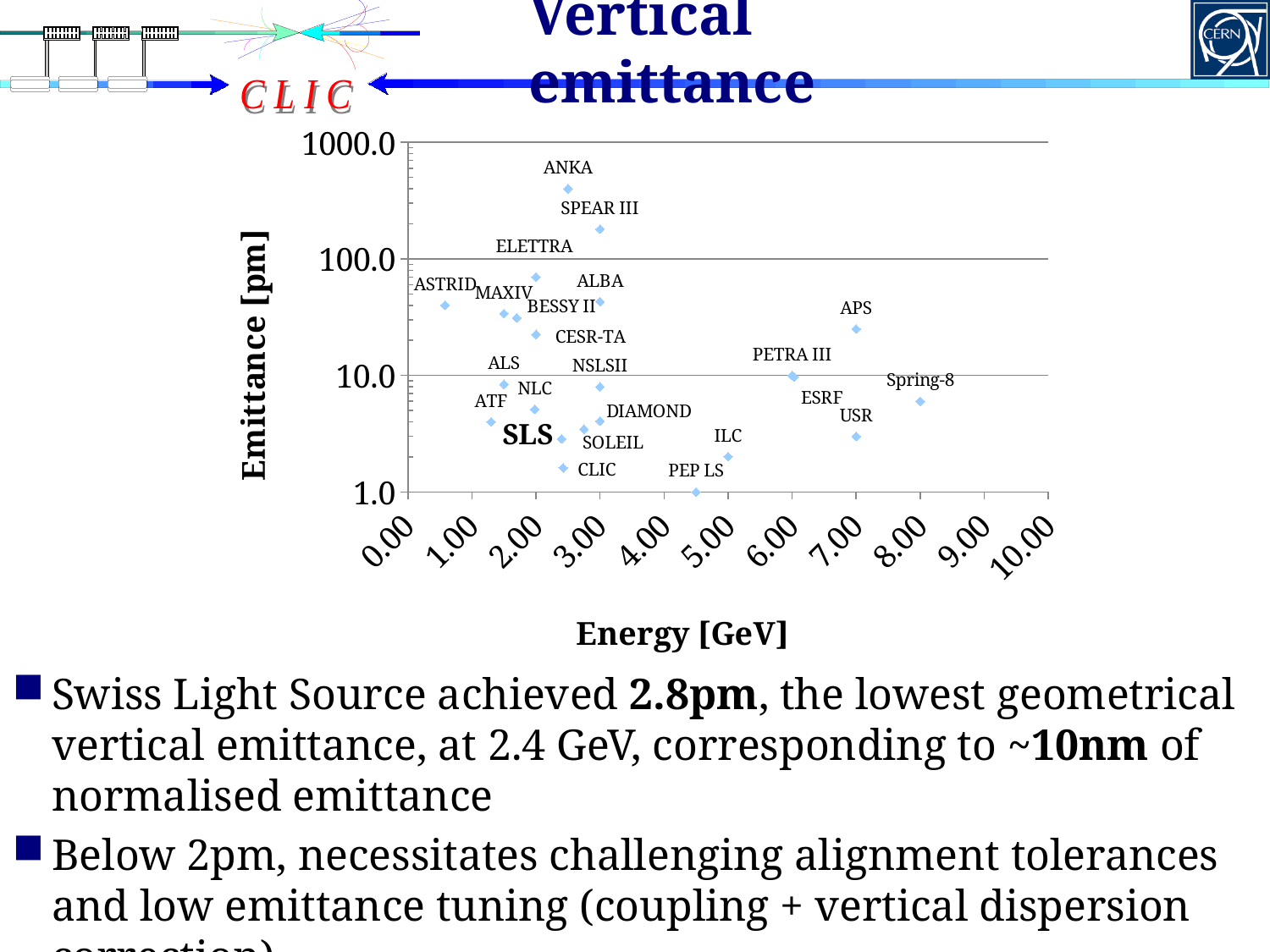
Which has the larger vertical emittance, APS or USR? APS What kind of chart is shown on the slide? scatter chart Is the emittance value for APS greater or less than 10.0 pm? greater Is the emittance value for ANKA greater or less than 100.0 pm? greater Which has the larger vertical emittance, ANKA or SPEAR III? ANKA Is the emittance value for ELETTRA greater or less than 100.0 pm? less What is the label of the y axis of the chart? Emittance [pm] Which facility has the lowest vertical emittance in the chart? PEP LS What is the label of the x axis of the chart? Energy [GeV] Which facility has the highest vertical emittance in the chart? ANKA